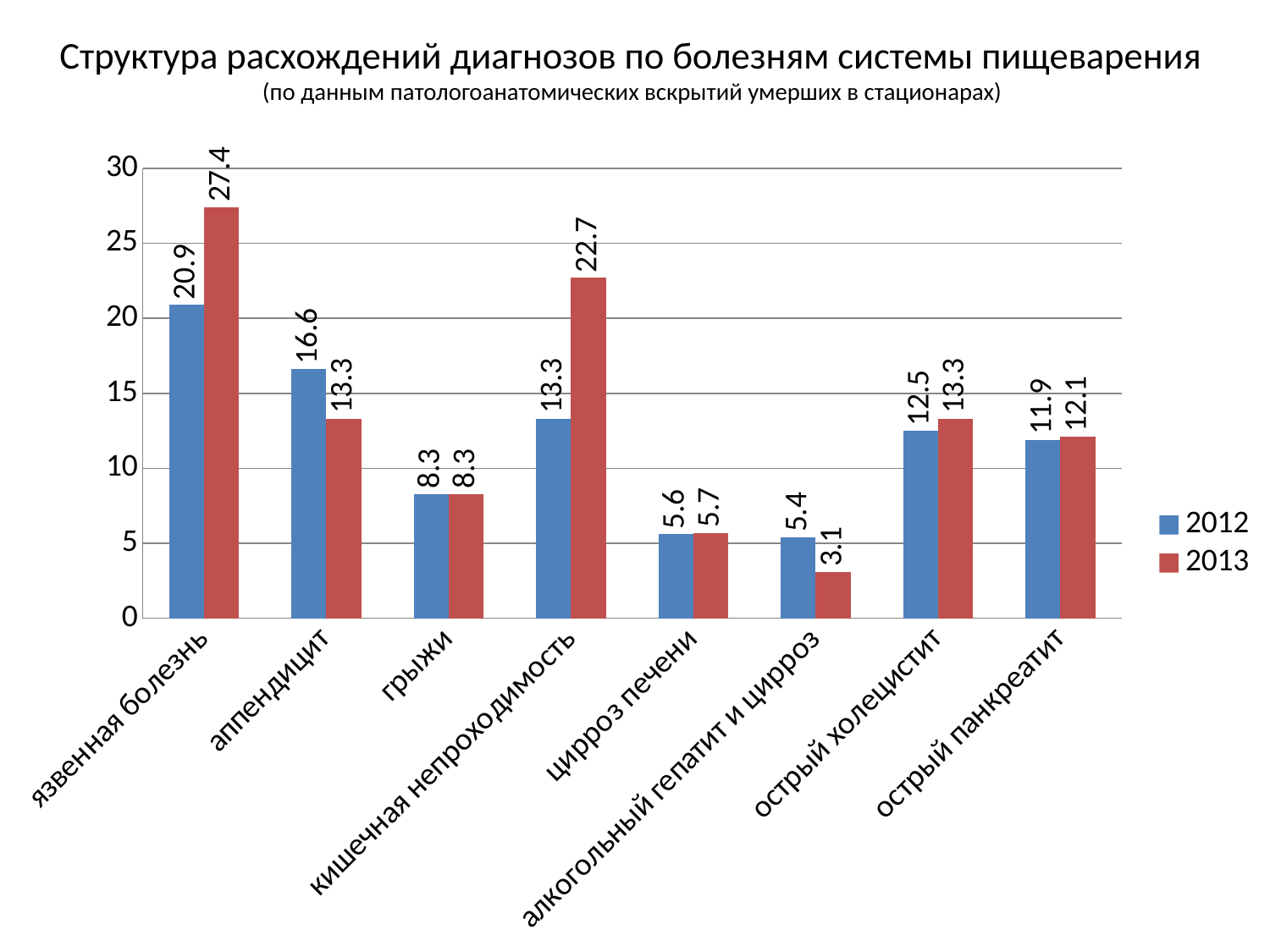
What kind of chart is shown on the slide? bar chart What is the difference between the 2013 and 2012 values for кишечная непроходимость? 9.4 How many series does the legend list? 2 How many categories are shown on the x axis? 8 Is the 2012 value for язвенная болезнь greater or less than 20? greater What is the 2013 value for язвенная болезнь? 27.4 Which category has the lowest 2012 value? алкогольный гепатит и цирроз What is the 2012 value for аппендицит? 16.6 Which category has the highest 2013 value? язвенная болезнь Which series is shown in red in the legend? 2013 What is the 2013 value for алкогольный гепатит и цирроз? 3.1 Which is larger for аппендицит: the 2012 value or the 2013 value? 2012